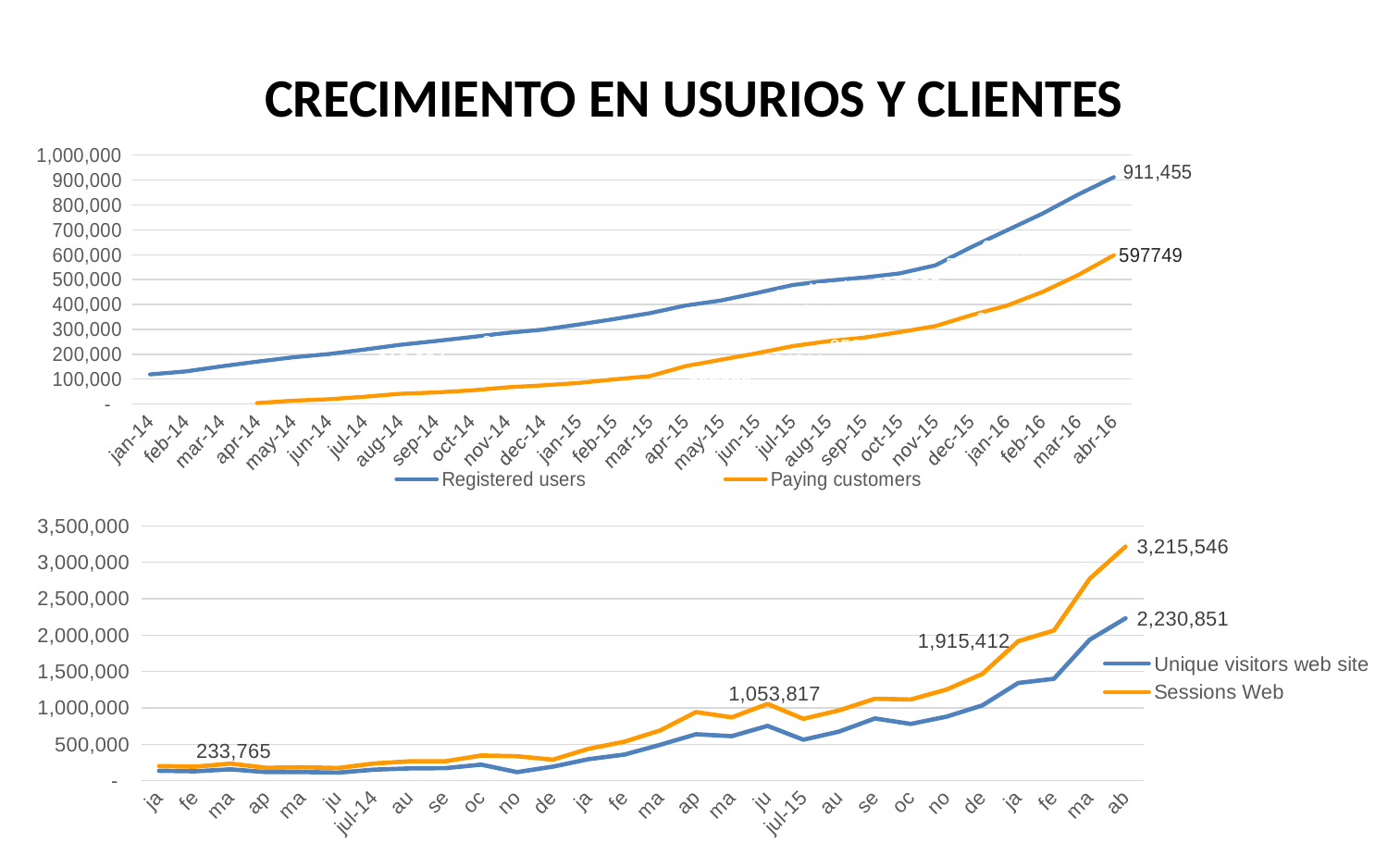
How many series does the legend of the top chart list? 2 What is the title of the slide? CRECIMIENTO EN USURIOS Y CLIENTES On the bottom chart, which series is higher at the last point, Sessions Web or Unique visitors web site? Sessions Web On the bottom chart, what is the value of Unique visitors web site at the last point (ab)? 2,230,851 On the top chart, is the value of Paying customers at dec-15 greater or less than 300,000? greater On the top chart, do the Registered users values rise or fall from jan-14 to abr-16? Rise On the top chart, is the value of Registered users at jan-14 greater or less than 200,000? less On the top chart, which series is higher at abr-16, Registered users or Paying customers? Registered users On the top chart, what is the value of Paying customers at abr-16? 597749 On the top chart, what is the value of Registered users at abr-16? 911,455 On the bottom chart, what is the value of Sessions Web at the last point (ab)? 3,215,546 What kind of chart is the bottom chart? Line chart